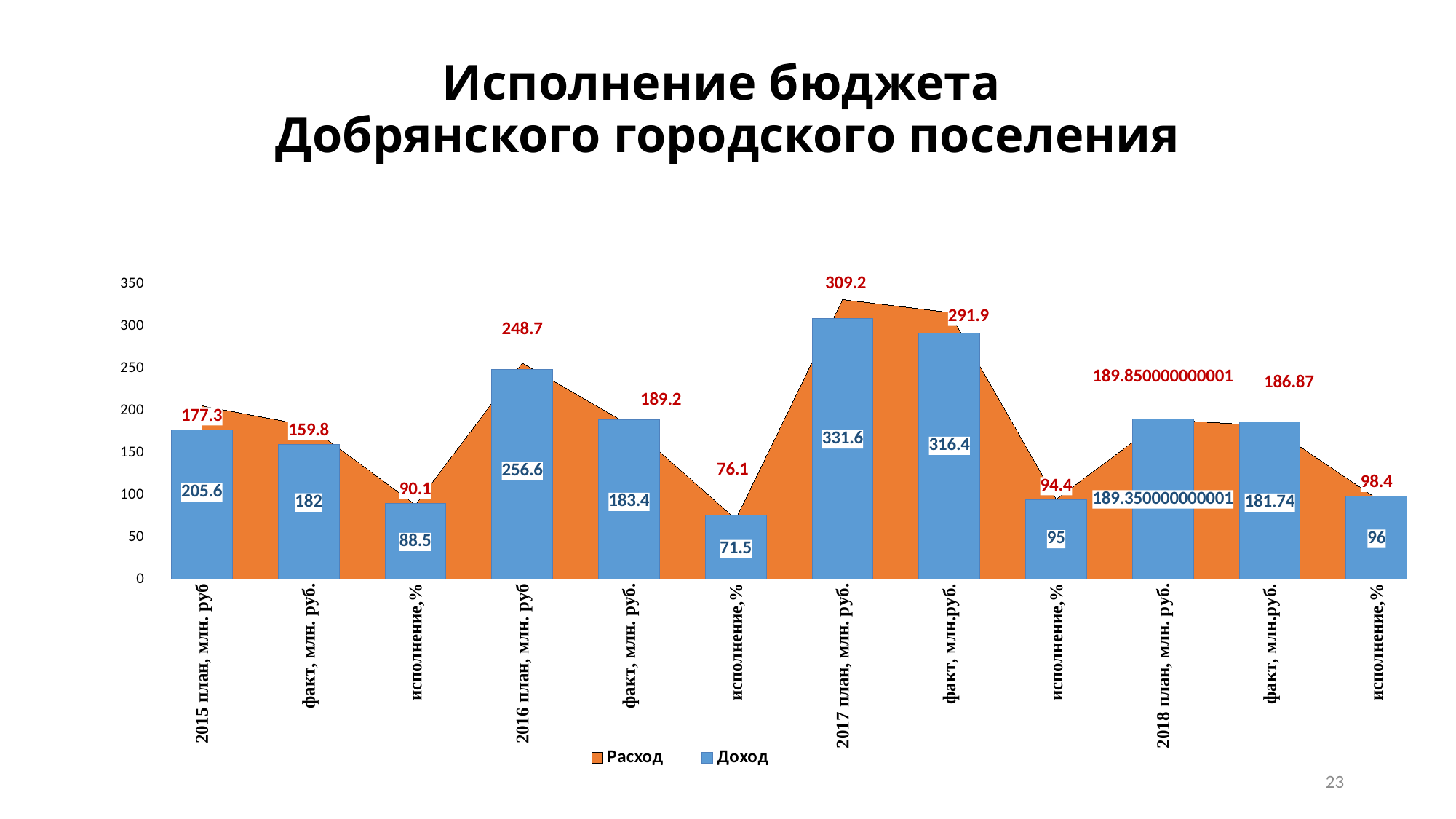
What is the Доход value for 2017 план, млн. руб.? 309.2 What is the difference between Доход and Расход for 2017 план, млн. руб.? 22.4 Which category has the lowest Расход value? 2016 исполнение,% How many categories are shown on the x axis? 12 What is the Расход value for 2018 факт, млн.руб.? 181.74 What are the two series named in the legend? Расход and Доход What is the difference between Доход and Расход for 2016 план, млн. руб.? 7.9 How many series does the legend list? 2 What is the Расход value for 2016 факт, млн. руб.? 183.4 Which category has the highest Доход value? 2017 план, млн. руб. What is the Доход value for 2018 исполнение,%? 98.4 For 2015 план, млн. руб., which is larger: Доход or Расход? Расход